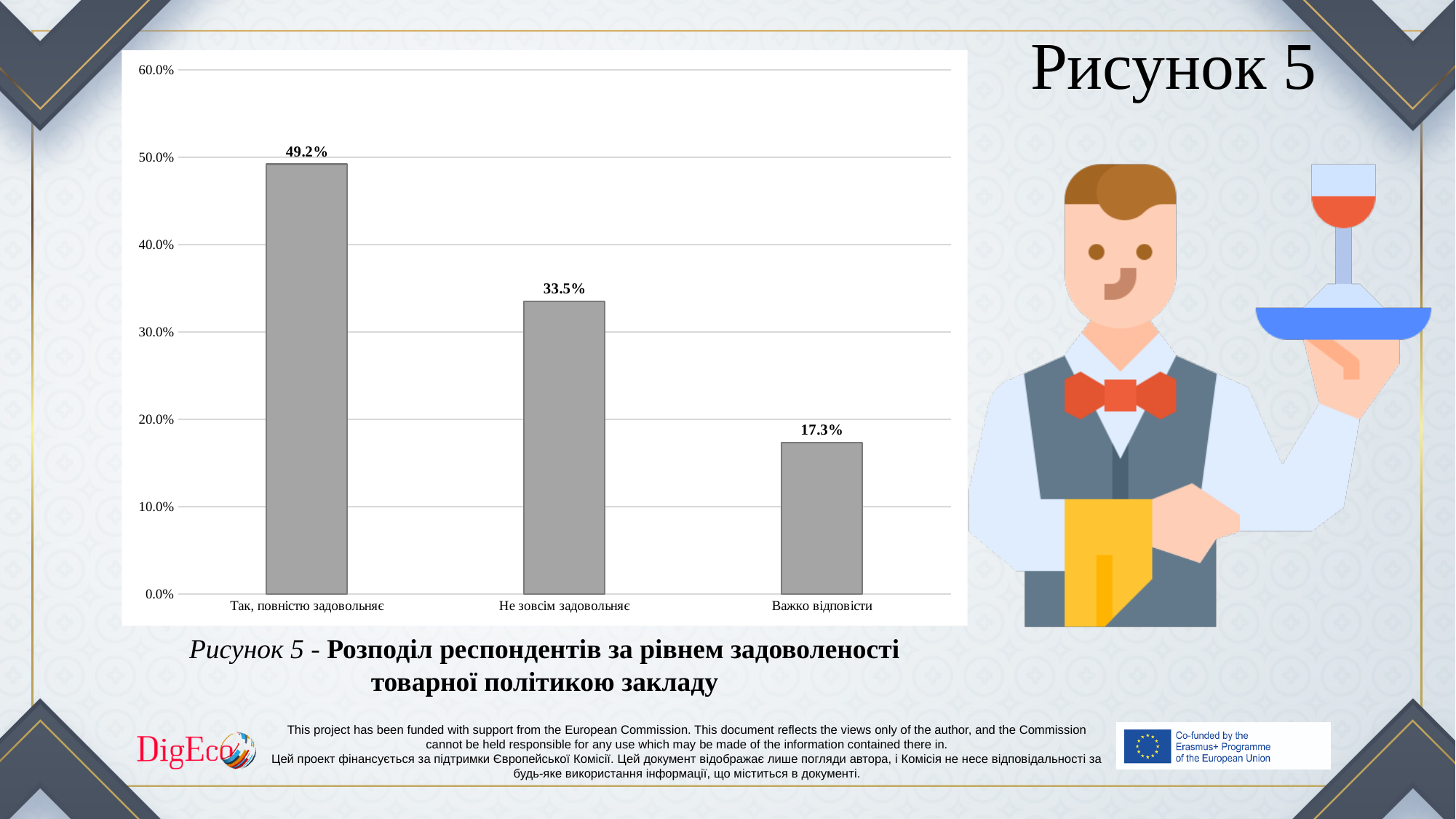
What kind of chart is shown on the slide? bar chart Which category has the highest value? Так, повністю задовольняє Is the value for "Важко відповісти" greater or less than 20.0%? less What is the value for "Не зовсім задовольняє"? 33.5% What is the difference between the values for "Так, повністю задовольняє" and "Не зовсім задовольняє"? 15.7% What is the value for "Важко відповісти"? 17.3% Which is larger, the value for "Не зовсім задовольняє" or the value for "Важко відповісти"? Не зовсім задовольняє Do the values rise or fall from left to right along the x axis? fall How many categories are shown on the chart? 3 What is the value for "Так, повністю задовольняє"? 49.2% Which category has the lowest value? Важко відповісти What is the difference between the values for "Не зовсім задовольняє" and "Важко відповісти"? 16.2%